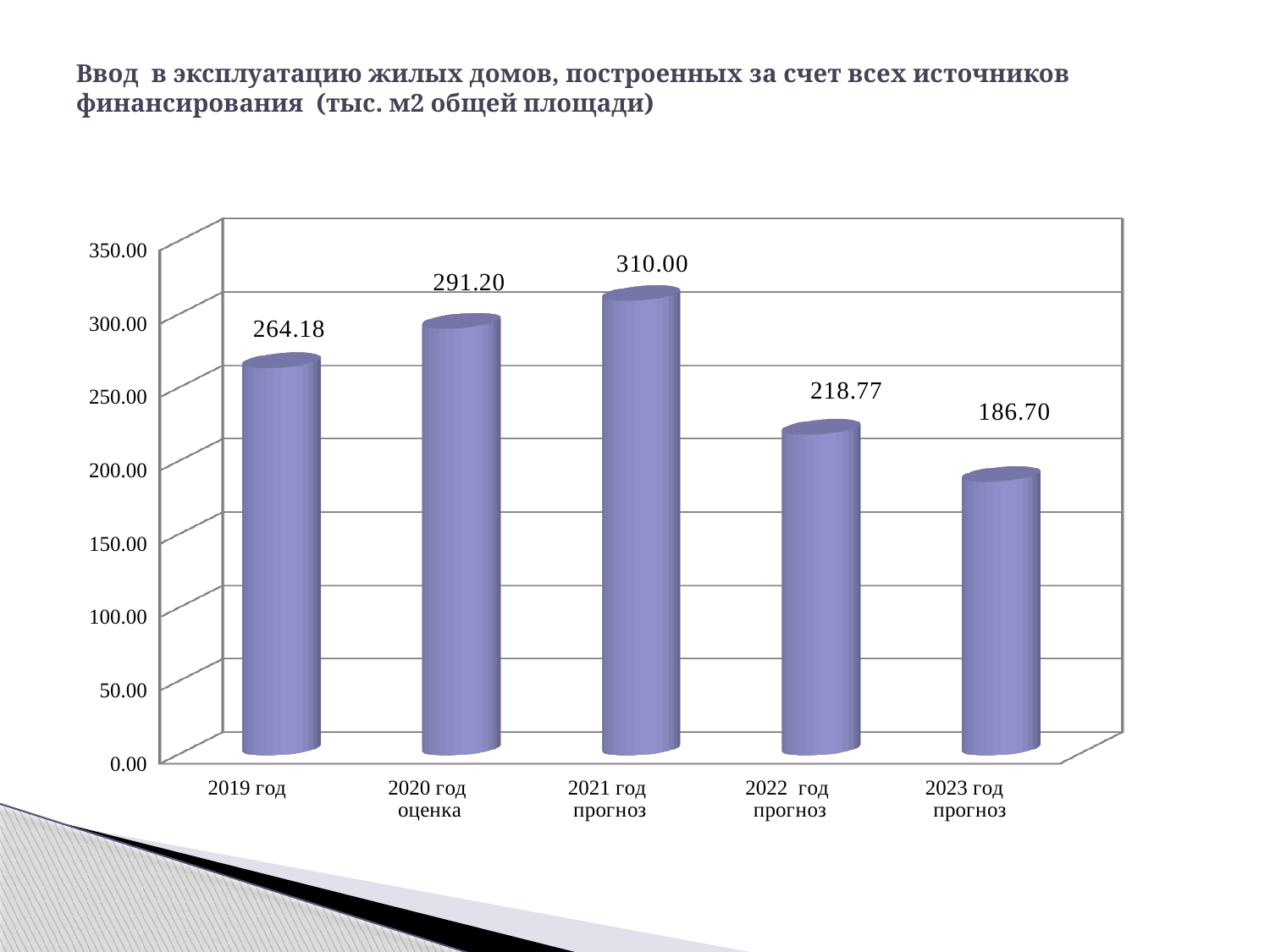
Do the values rise or fall from 2021 год прогноз to 2023 год прогноз? fall Which year has the lowest value? 2023 год прогноз Which is larger, the value for 2020 год оценка or the value for 2022 год прогноз? 2020 год оценка What is the value for 2019 год? 264.18 How many categories are shown on the x axis? 5 What is the difference between the values for 2021 год прогноз and 2022 год прогноз? 91.23 Is the value for 2022 год прогноз greater or less than 250.00? less What is the difference between the values for 2020 год оценка and 2019 год? 27.02 What is the value for 2021 год прогноз? 310.00 What kind of chart is shown on the slide? bar chart What is the value for 2023 год прогноз? 186.70 Which year has the highest value? 2021 год прогноз